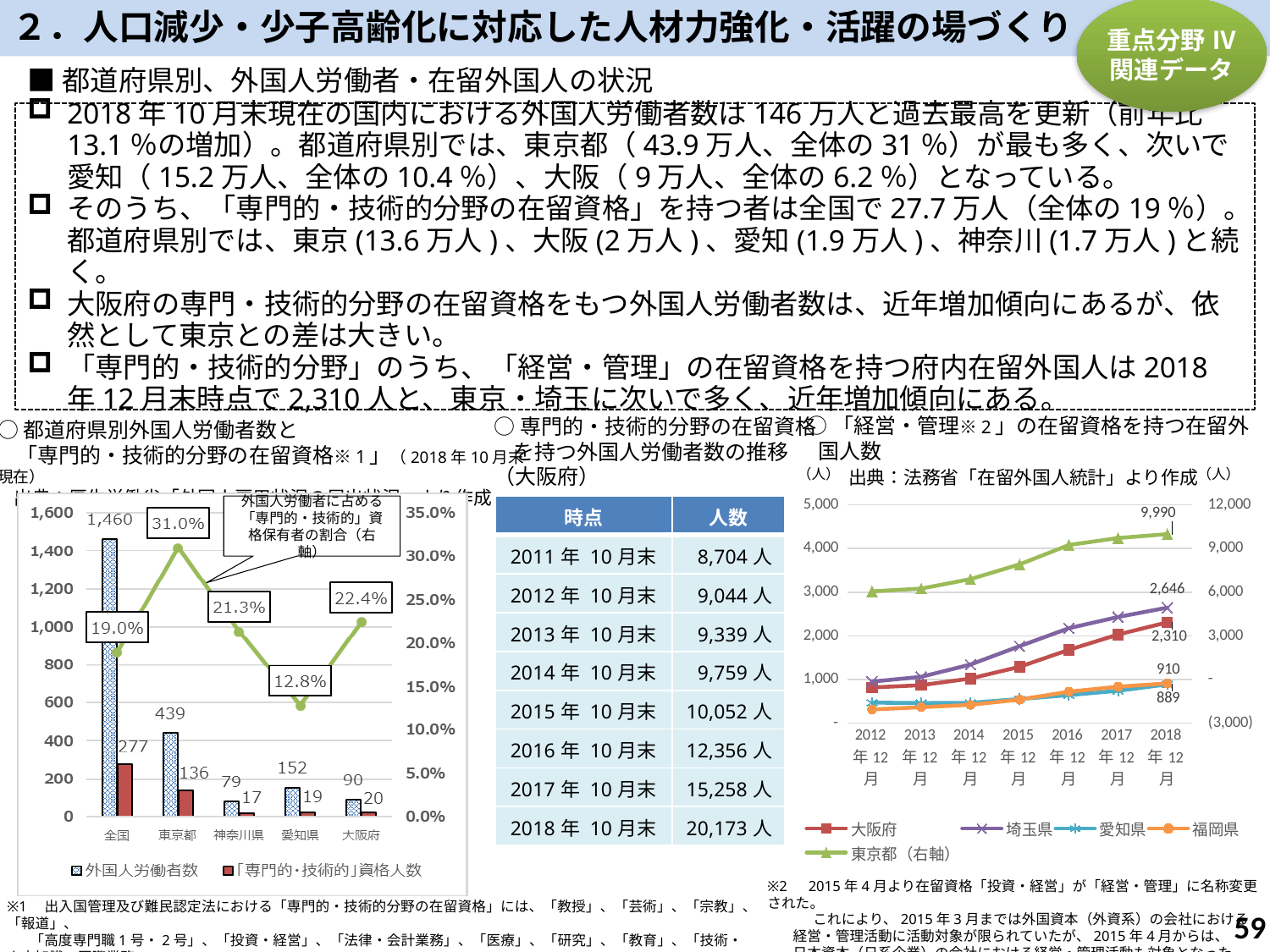
In the left bar chart, what percentage is shown for 東京都 on the line (share of 専門的・技術的 資格保有者)? 31.0% In the left bar chart, what is the 「専門的・技術的」資格人数 value for 大阪府? 20 In the left bar chart (都道府県別外国人労働者数), what is the 外国人労働者数 value for 東京都? 439 In the left bar chart, which prefecture (excluding 全国) has the lowest 外国人労働者数? 神奈川県 In the right line chart (「経営・管理」の在留資格を持つ在留外国人数), what is the value for 大阪府 in 2018年12月? 2,310 In the right line chart, what is the value for 東京都 in 2018年12月? 9,990 In the left bar chart, which is larger: the 「専門的・技術的」資格人数 for 東京都 or for 大阪府? 東京都 In the right line chart, does the value for 大阪府 rise or fall from 2012 to 2018? rise In the left bar chart, what is the difference between the 外国人労働者数 and the 「専門的・技術的」資格人数 for 愛知県? 133 In the left bar chart, how many categories are shown on the x axis? 5 In the right line chart, how many series does the legend list? 5 In the left bar chart, which category has the lowest percentage on the line? 愛知県